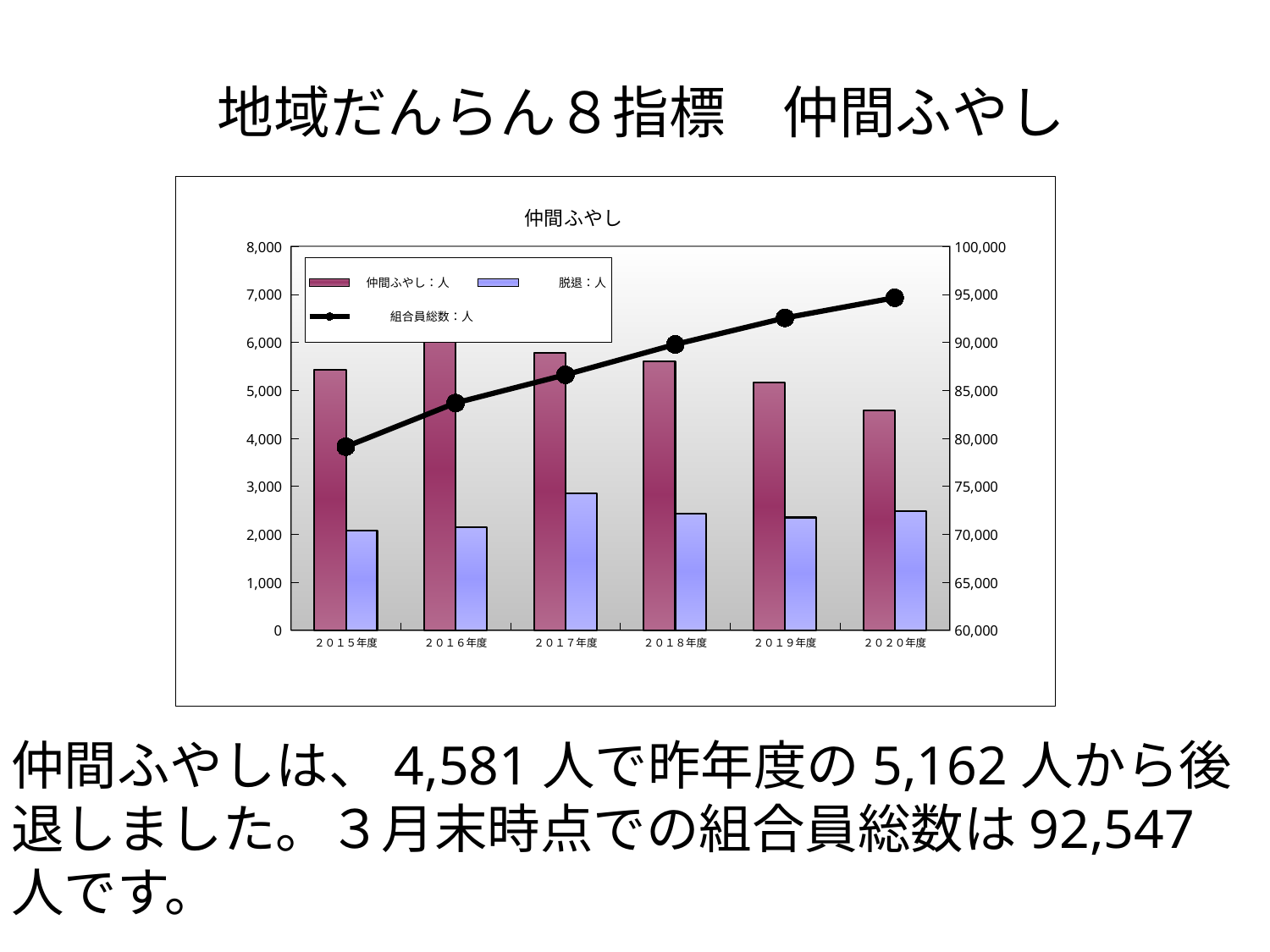
How many fiscal years are shown on the x axis of the chart? 6 Which fiscal year has the highest 仲間ふやし：人 bar? 2016年度 What is the title of the chart? 仲間ふやし Is the 仲間ふやし：人 value for 2020年度 greater or less than 5,000? less Which fiscal year has the highest 脱退：人 bar? 2017年度 In 2020年度, which is larger, the 仲間ふやし：人 bar or the 脱退：人 bar? 仲間ふやし：人 Is the 脱退：人 value for 2017年度 greater or less than 3,000? less Which fiscal year has the lowest 仲間ふやし：人 bar? 2020年度 What kind of chart is shown on the slide? Combined bar and line chart How many series does the chart legend list? 3 Does the 組合員総数：人 line rise or fall from 2015年度 to 2020年度? Rises